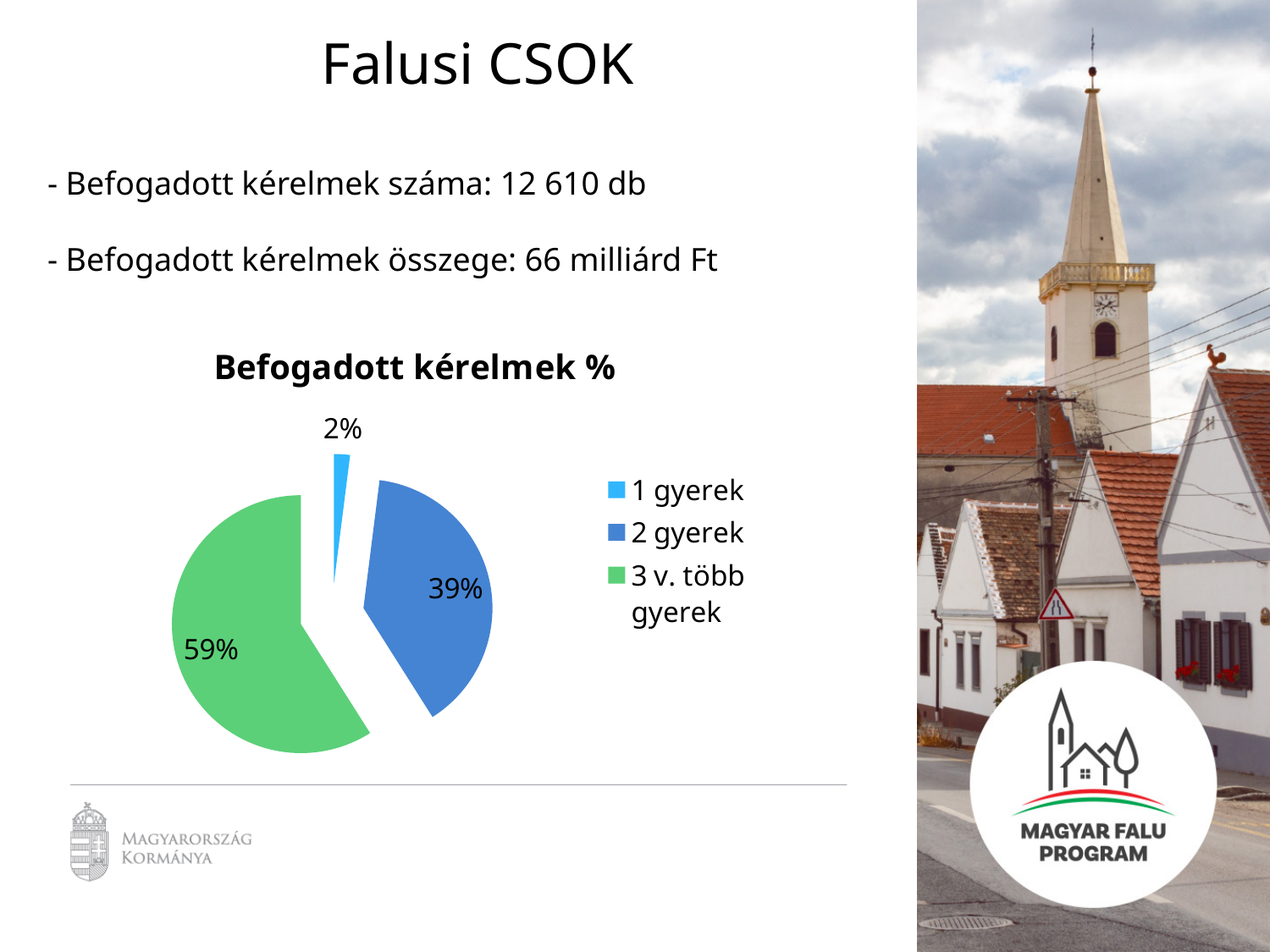
Which is larger, the share for '2 gyerek' or the share for '1 gyerek'? 2 gyerek What share of the pie does the '2 gyerek' slice represent? 39% What share of the pie does the '3 v. több gyerek' slice represent? 59% How many entries does the legend list? 3 Which category has the smallest share of the pie? 1 gyerek What colour is the '3 v. több gyerek' slice? green What type of chart is shown on the slide? pie chart How many slices does the pie chart have? 3 Which category has the largest share of the pie? 3 v. több gyerek What is the difference in percentage points between the '3 v. több gyerek' and '2 gyerek' slices? 20 What is the title of the chart? Befogadott kérelmek % What share of the pie does the '1 gyerek' slice represent? 2%